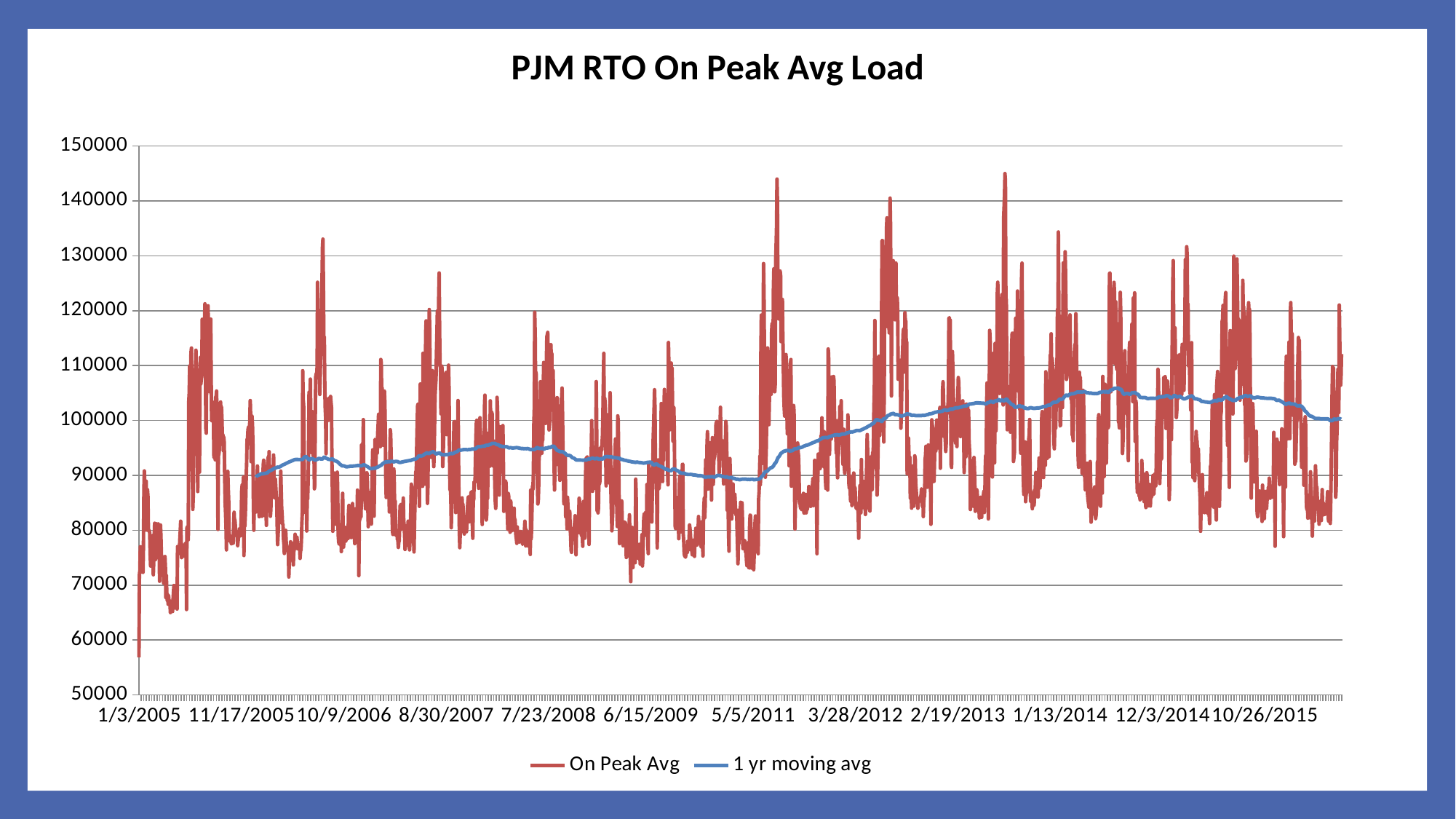
Is the lowest On Peak Avg value, at the very start of the series near 1/3/2005, greater or less than 60000? less What are the two series named in the legend? On Peak Avg and 1 yr moving avg Does the 1 yr moving avg line rise or fall overall from its start near 11/17/2005 to its end in 2016? rise Is the value of the 1 yr moving avg around 1/13/2014 greater or less than 100000? greater What is the maximum value shown on the vertical axis? 150000 What is the title of the chart? PJM RTO On Peak Avg Load Is the value of the 1 yr moving avg around 6/15/2009 greater or less than 100000? less How many series does the legend list? 2 What kind of chart is shown on the slide? line chart Which series is more volatile, On Peak Avg or 1 yr moving avg? On Peak Avg